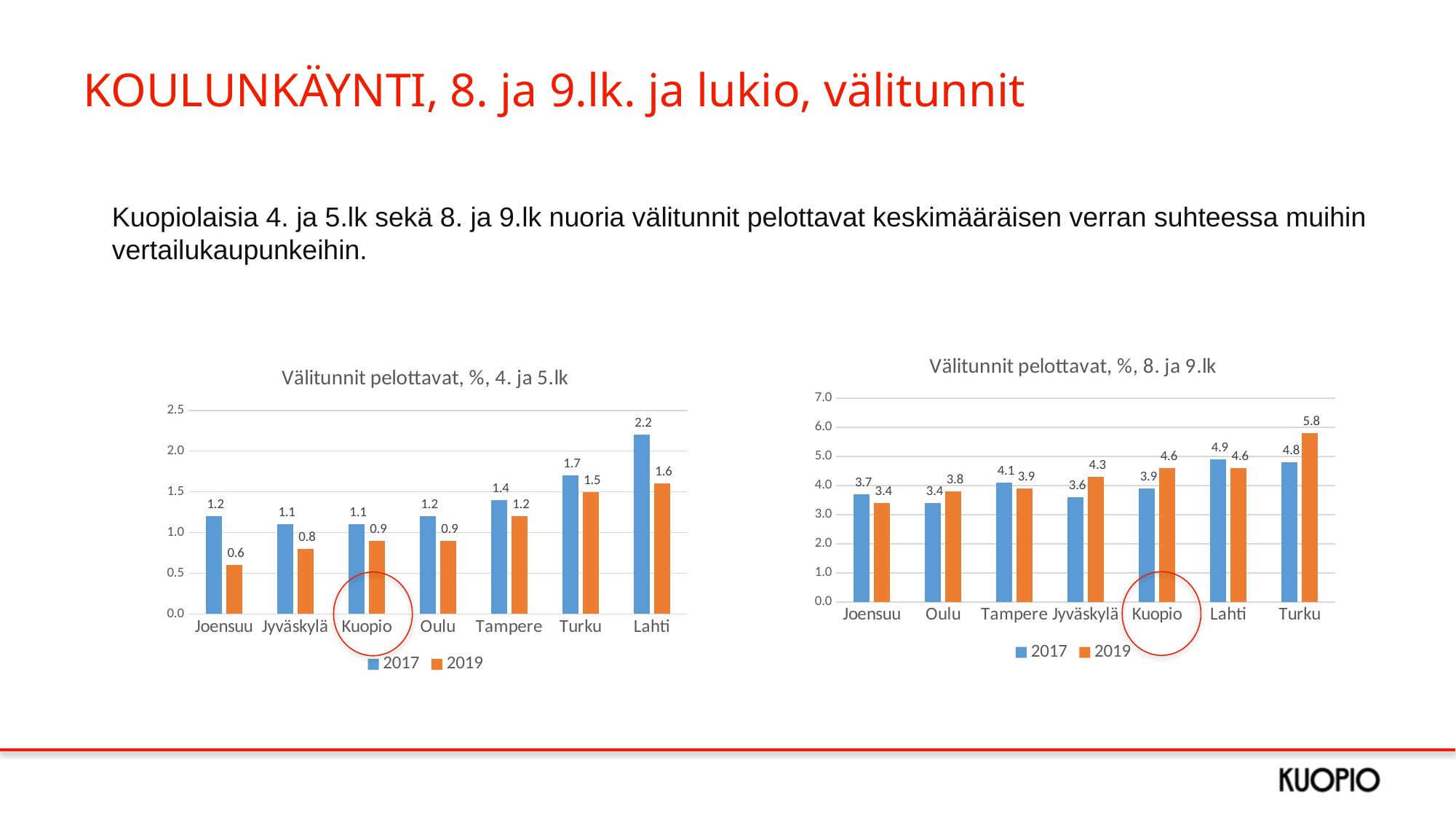
In the chart 'Välitunnit pelottavat, %, 4. ja 5.lk', which city has the highest value for 2017? Lahti In the chart 'Välitunnit pelottavat, %, 8. ja 9.lk', what is the value for Turku in 2019? 5.8 In the chart 'Välitunnit pelottavat, %, 8. ja 9.lk', what is the value for Kuopio in 2017? 3.9 In the chart 'Välitunnit pelottavat, %, 4. ja 5.lk', what is the value for Kuopio in 2019? 0.9 In the chart 'Välitunnit pelottavat, %, 4. ja 5.lk', what is the difference between the 2017 and 2019 values for Lahti? 0.6 In the chart 'Välitunnit pelottavat, %, 8. ja 9.lk', which city has the lowest value for 2017? Oulu What type of chart is 'Välitunnit pelottavat, %, 4. ja 5.lk'? Bar chart In the chart 'Välitunnit pelottavat, %, 4. ja 5.lk', how many cities are shown on the x axis? 7 How many series does the legend list in the chart 'Välitunnit pelottavat, %, 8. ja 9.lk'? 2 In the chart 'Välitunnit pelottavat, %, 8. ja 9.lk', which is larger for Jyväskylä: the 2017 value or the 2019 value? 2019 In the chart 'Välitunnit pelottavat, %, 8. ja 9.lk', what is the difference between the 2019 and 2017 values for Turku? 1.0 In the chart 'Välitunnit pelottavat, %, 4. ja 5.lk', which city has the lowest value for 2019? Joensuu